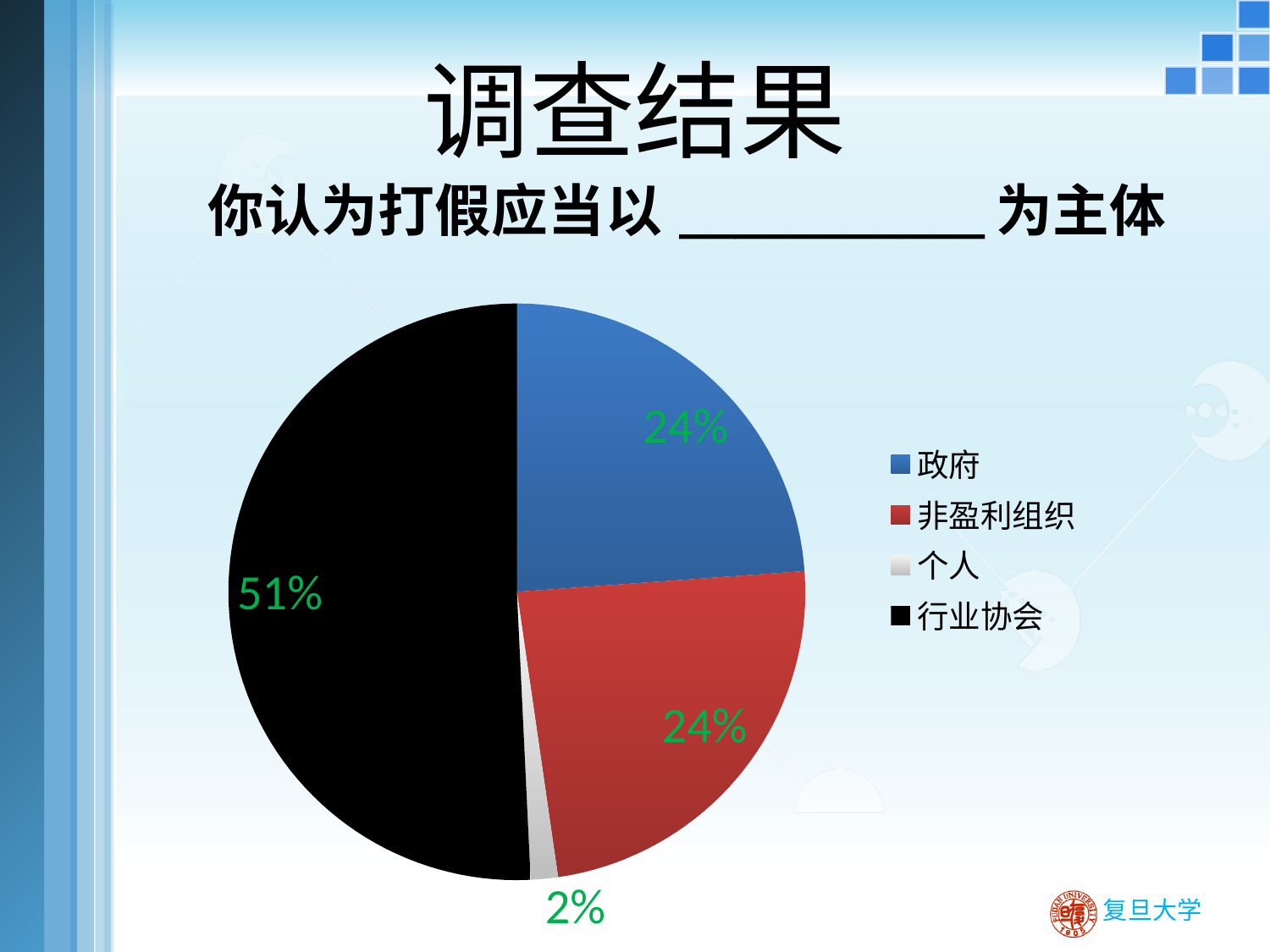
Which category has the smallest slice of the pie? 个人 How many entries does the legend list? 4 What percentage of the pie is labelled for 个人? 2% What percentage of the pie is labelled for 非盈利组织? 24% What percentage of the pie is labelled for 政府? 24% Which category has the largest slice of the pie? 行业协会 How many categories does the pie chart have? 4 What percentage of the pie is labelled for 行业协会? 51% By how many percentage points does the 行业协会 slice exceed the 非盈利组织 slice? 27 What colour is the slice for 非盈利组织? red Which slice is larger, 行业协会 or 政府? 行业协会 What kind of chart is shown on the slide? pie chart